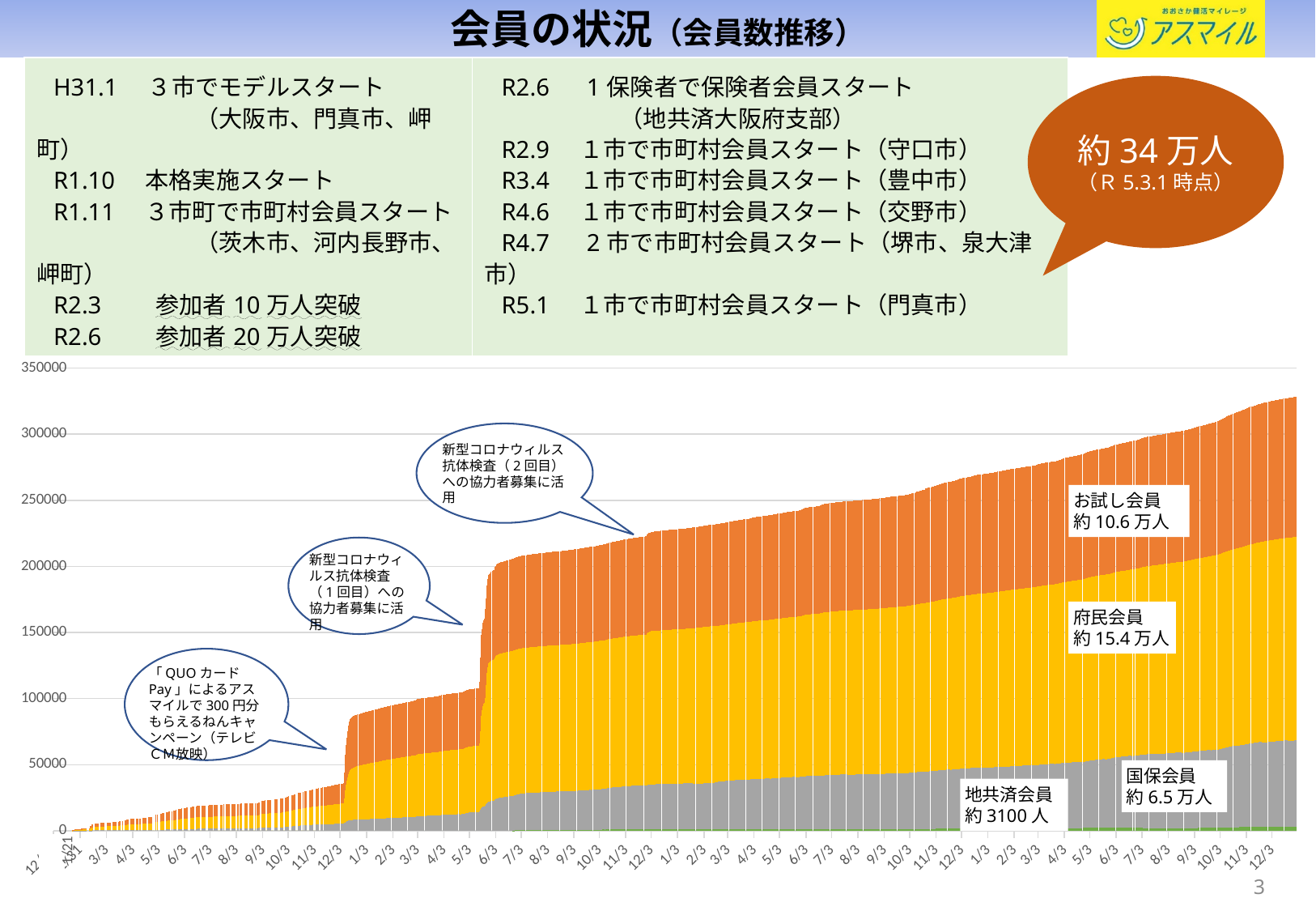
What is the labelled number of 府民会員 on the chart? 約15.4万人 What is the title of the slide containing the chart? 会員の状況（会員数推移） Is the total member count at the right end of the chart greater or less than 300000? greater What is the labelled number of お試し会員 on the chart? 約10.6万人 Which member category has the smallest labelled count? 地共済会員 Which member category has the largest labelled count? 府民会員 What total member count is shown in the callout bubble as of R5.3.1? 約34万人 What is the labelled number of 地共済会員 on the chart? 約3100人 Do the total member counts rise or fall along the x axis over time? rise What is the labelled number of 国保会員 on the chart? 約6.5万人 What kind of chart is shown on the slide? stacked bar chart Which is larger, the count of 府民会員 or the count of 国保会員? 府民会員